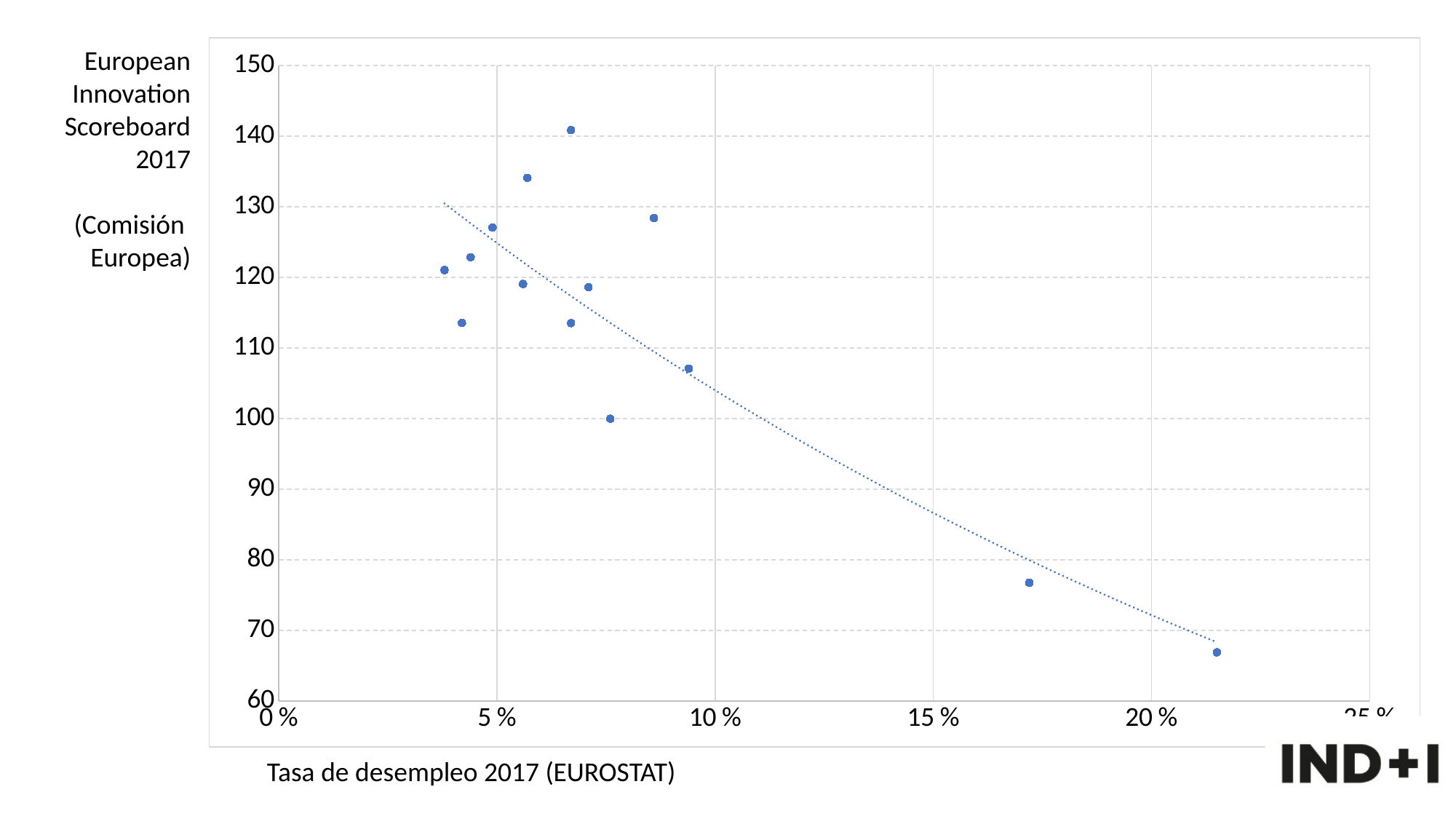
How many data points are plotted on the chart? 14 Is the European Innovation Scoreboard value of the point with the highest unemployment rate greater or less than 70? less As the unemployment rate increases along the x axis, do the European Innovation Scoreboard values generally rise or fall? Fall Is the unemployment rate of the point with the highest European Innovation Scoreboard value greater or less than 10 %? less What is the label of the y axis? European Innovation Scoreboard 2017 (Comisión Europea) Is the European Innovation Scoreboard value of the point at roughly 17 % unemployment greater or less than 80? less What kind of chart is shown on the slide? Scatter plot What is the label of the x axis? Tasa de desempleo 2017 (EUROSTAT)